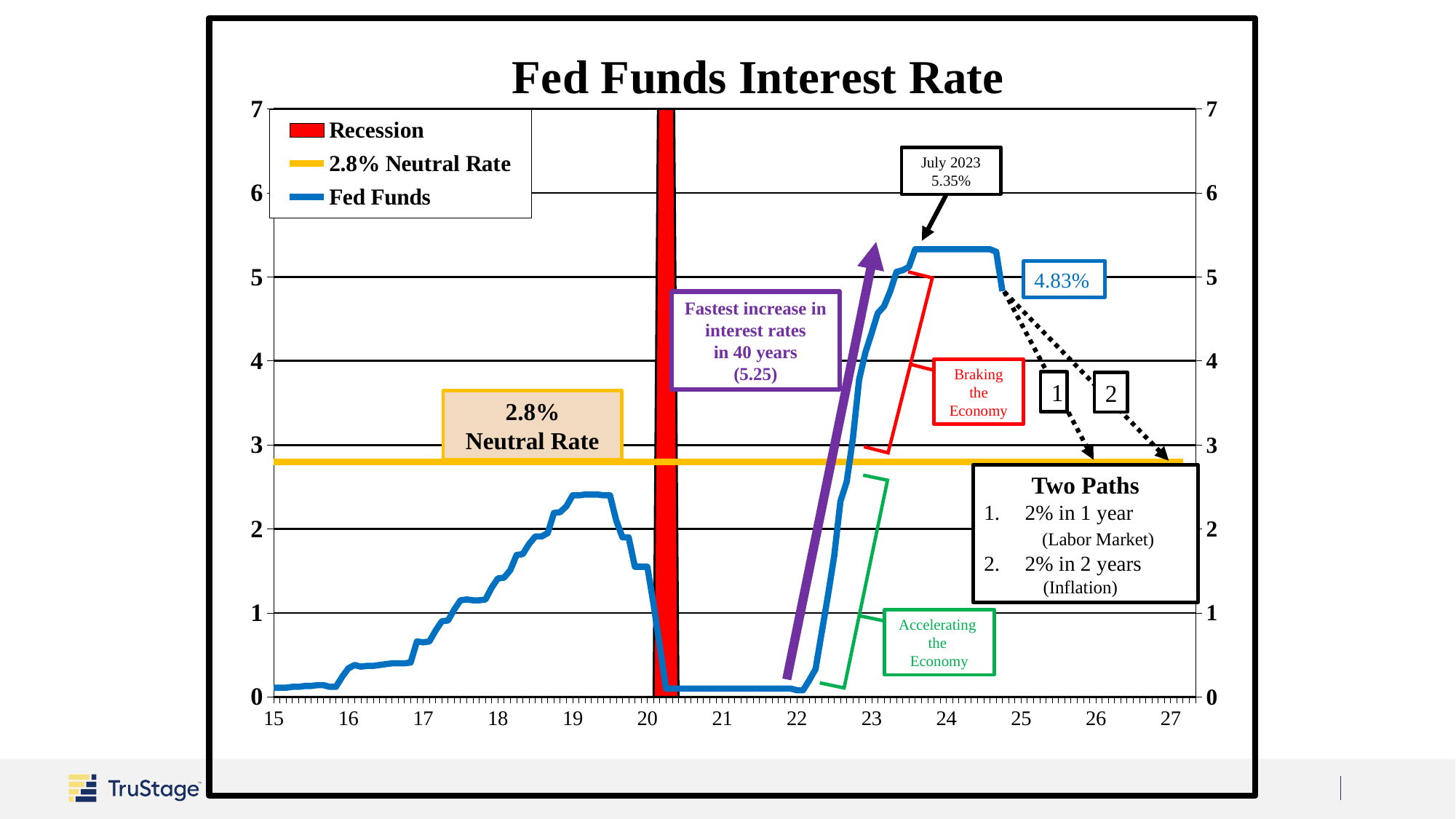
How many entries does the chart's legend list? 3 What is the title of the chart? Fed Funds Interest Rate What does the red vertical bar around 2020 represent according to the legend? Recession What kind of chart is shown on the slide? line chart What is the difference between the July 2023 rate of 5.35% and the later labeled rate of 4.83%? 0.52% Which is larger, the July 2023 rate or the later labeled rate of 4.83%? July 2023 (5.35%) Is the Fed Funds rate during 2024 greater or less than 5? greater What is the most recent Fed Funds rate labeled on the chart after the decline from the 2024 plateau? 4.83% What Fed Funds rate is labeled for July 2023? 5.35% Is the Fed Funds rate at the start of 2021 greater or less than 1? less Does the Fed Funds rate rise or fall between 2022 and 2023? rise What is the value of the neutral rate shown as the horizontal yellow line? 2.8%